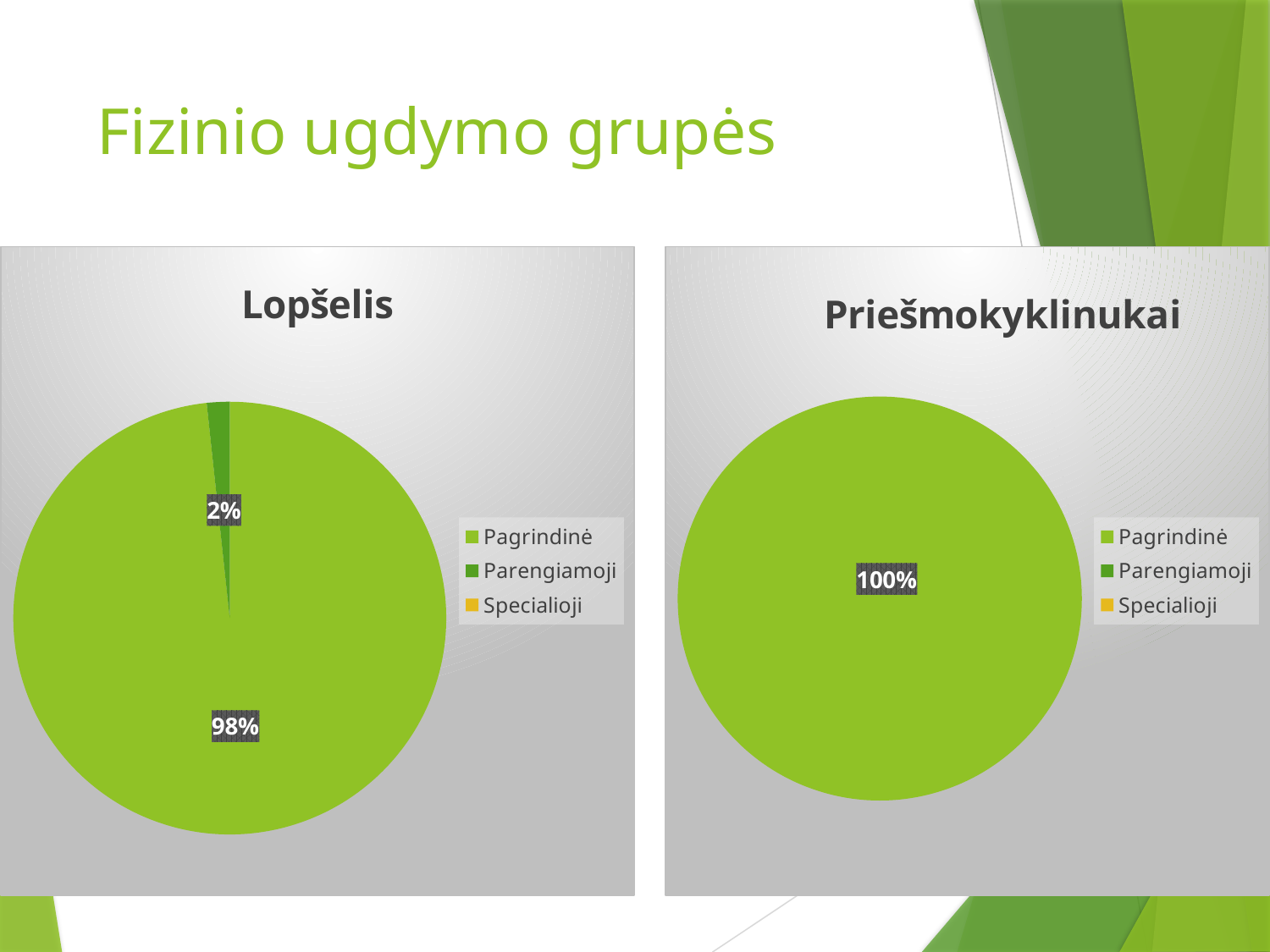
How many entries does the legend of the "Priešmokyklinukai" chart list? 3 In the "Lopšelis" chart, what share does Parengiamoji have? 2% In the "Lopšelis" chart, what is the difference between the Pagrindinė and Parengiamoji shares? 96% What is the title of the chart on the left side of the slide? Lopšelis What kind of chart is the "Lopšelis" chart? pie chart In the "Priešmokyklinukai" chart, what share does Pagrindinė have? 100% In the "Lopšelis" chart, which is larger, Pagrindinė or Parengiamoji? Pagrindinė In the "Lopšelis" chart, which category has the largest slice? Pagrindinė What is the title of the chart on the right side of the slide? Priešmokyklinukai What kind of chart is the "Priešmokyklinukai" chart? pie chart In the "Lopšelis" chart, what share does Pagrindinė have? 98% How many entries does the legend of the "Lopšelis" chart list? 3